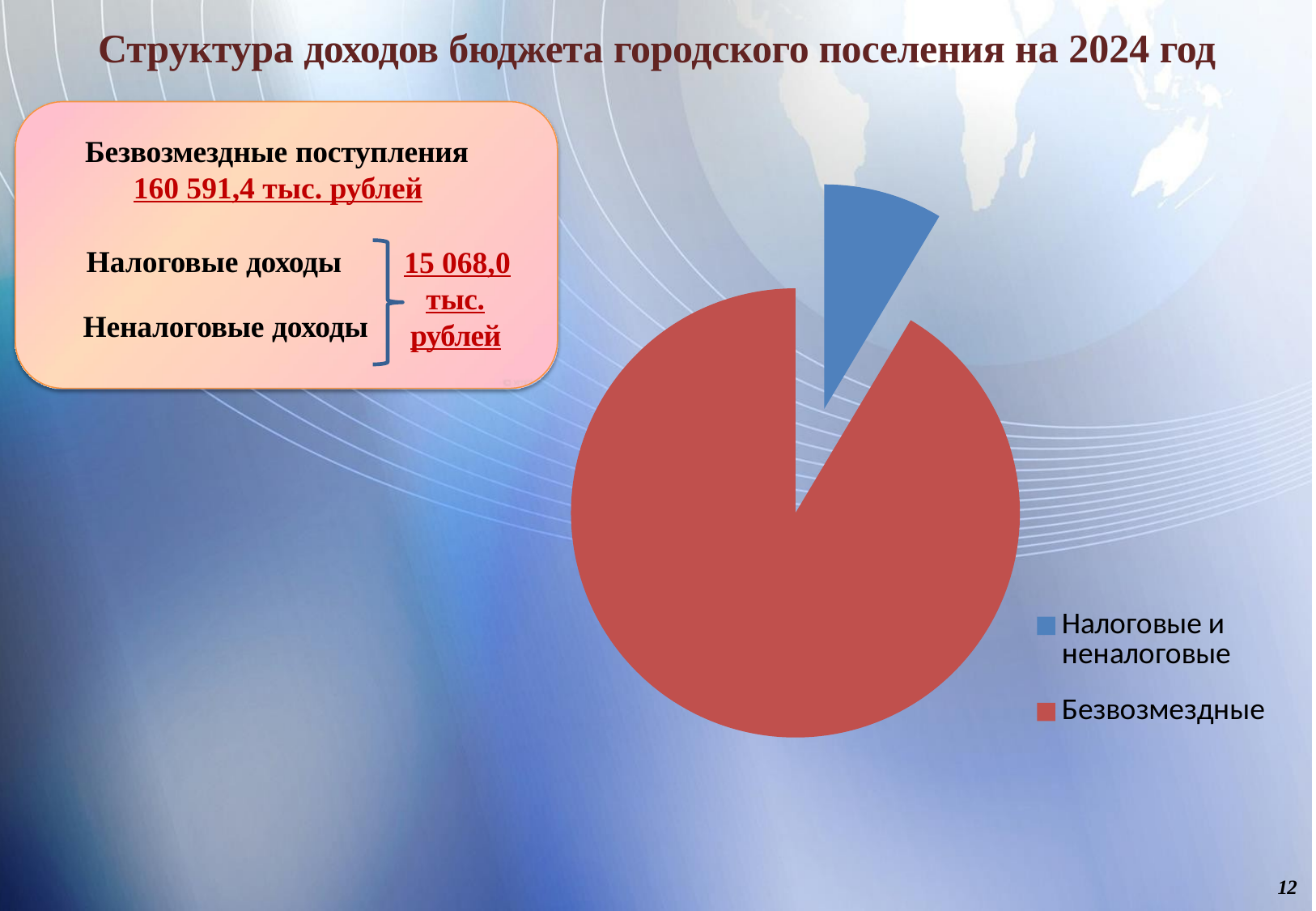
How many slices does the pie chart have? 2 By how much do Безвозмездные поступления (160 591,4) exceed Налоговые и неналоговые доходы (15 068,0), in тыс. рублей? 145 523,4 According to the slide, what is the combined value of Налоговые доходы and Неналоговые доходы? 15 068,0 тыс. рублей Which is larger in the pie chart: Безвозмездные or Налоговые и неналоговые? Безвозмездные What kind of chart is shown on the slide? pie chart Which category has the largest slice in the pie chart? Безвозмездные What is the title of the slide containing the pie chart? Структура доходов бюджета городского поселения на 2024 год How many entries does the legend of the pie chart list? 2 Which category has the smallest slice in the pie chart? Налоговые и неналоговые What colour is the Безвозмездные slice in the pie chart? red According to the slide, what is the value of Безвозмездные поступления? 160 591,4 тыс. рублей